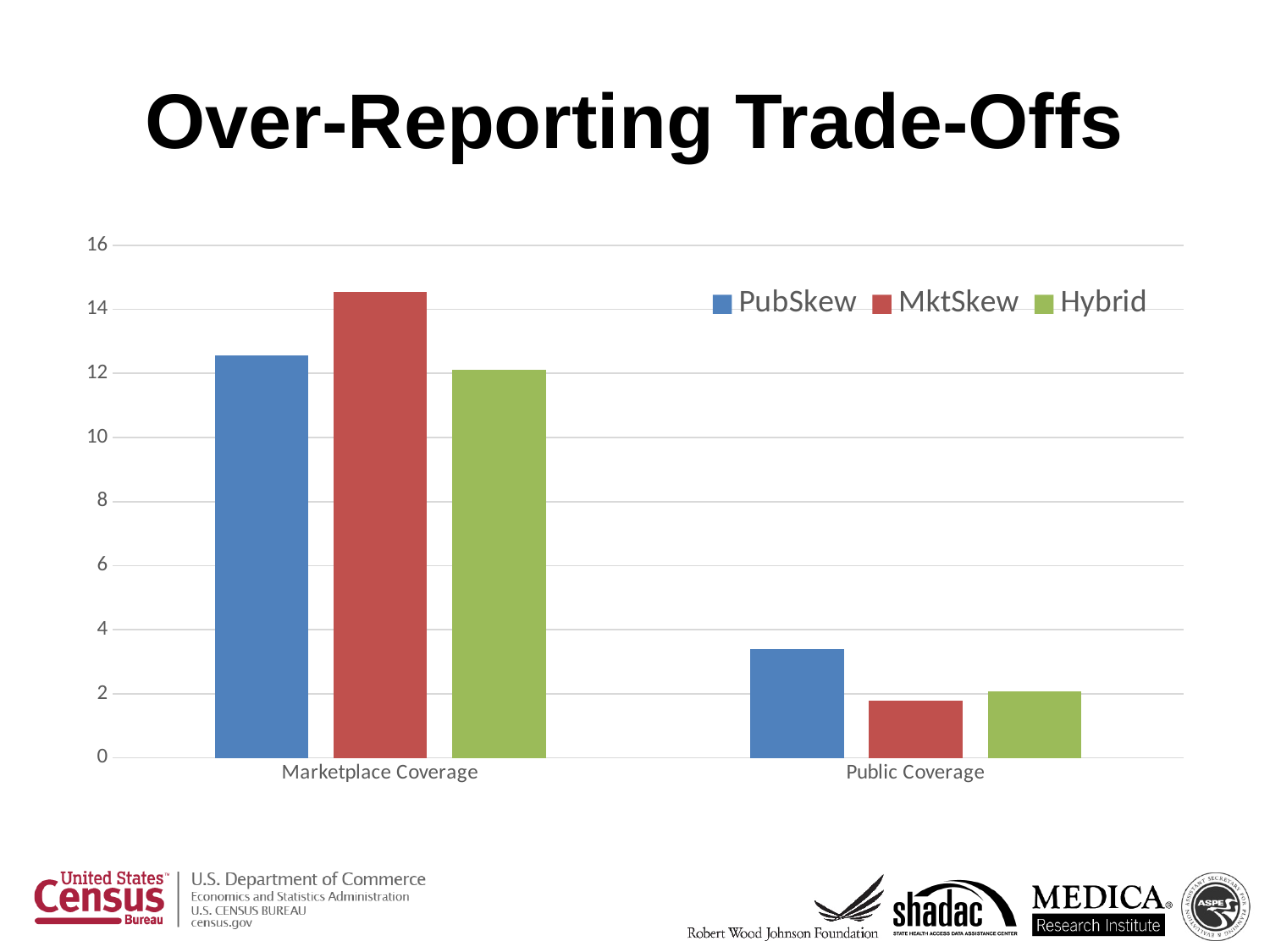
Is the PubSkew value for Marketplace Coverage greater or less than 12? greater What kind of chart is shown on the slide? bar chart Is the MktSkew value for Marketplace Coverage greater or less than 14? greater How many categories are shown on the x axis? 2 Which is larger: the PubSkew value for Marketplace Coverage or the PubSkew value for Public Coverage? Marketplace Coverage Which series is shown in green in the legend? Hybrid How many series does the legend list? 3 Is the PubSkew value for Public Coverage greater or less than 4? less Which series has the highest value for Marketplace Coverage? MktSkew Which series has the highest value for Public Coverage? PubSkew What is the title of the chart on the slide? Over-Reporting Trade-Offs